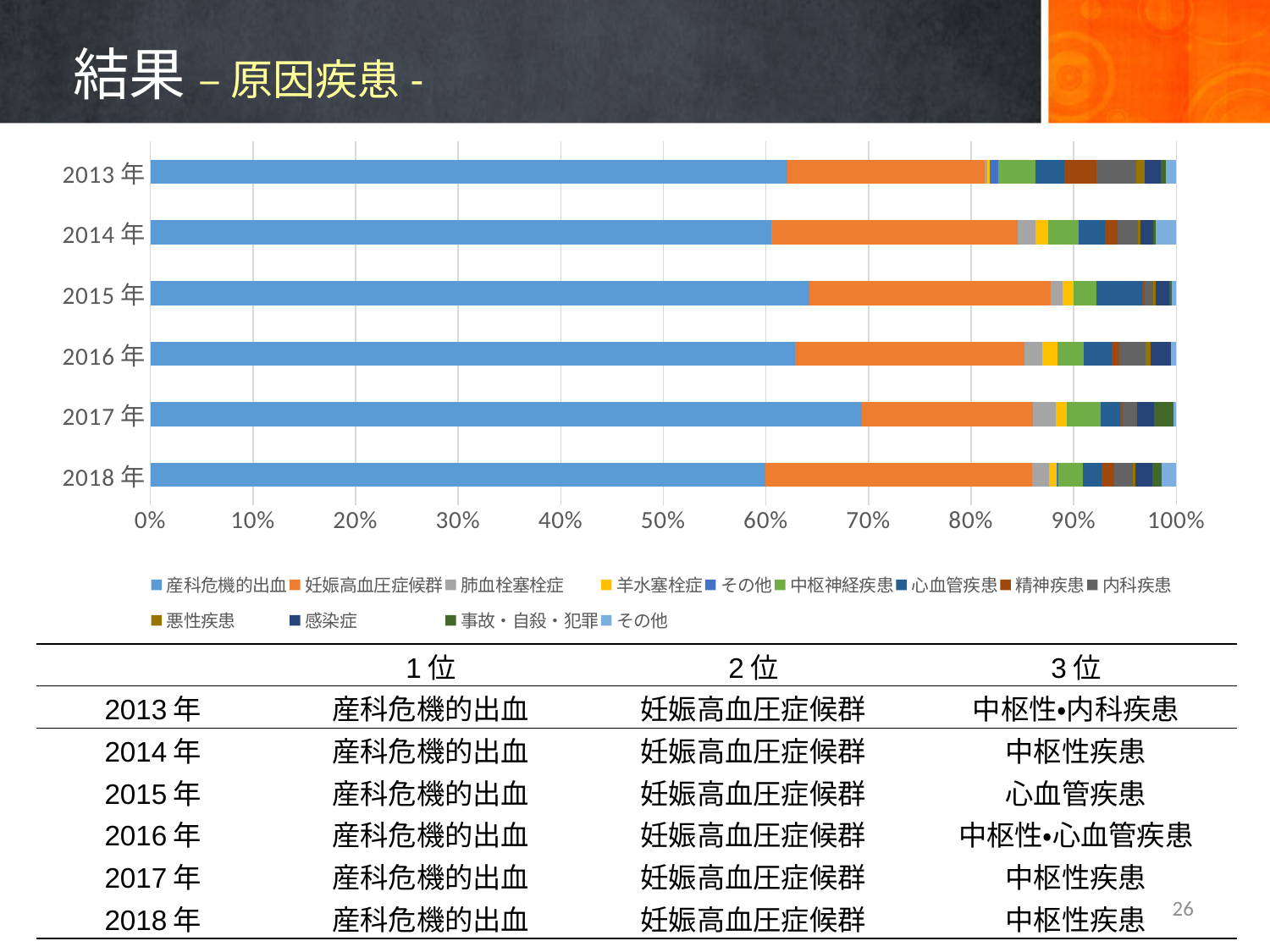
Is the share of 産科危機的出血 in 2013年 greater or less than 50%? greater Which series is listed first in the chart legend? 産科危機的出血 Is the share of 産科危機的出血 in 2014年 greater or less than 70%? less How many years (categories) are plotted in the chart? 6 Which year has the largest share for 産科危機的出血? 2017年 What is the first year shown at the top of the chart? 2013年 Is the share of 産科危機的出血 in 2017年 greater or less than 60%? greater What kind of chart is shown on the slide? stacked bar chart Which year has a larger share of 産科危機的出血, 2017年 or 2018年? 2017年 Which year has a larger share of 産科危機的出血, 2014年 or 2017年? 2017年 How many series does the chart legend list? 13